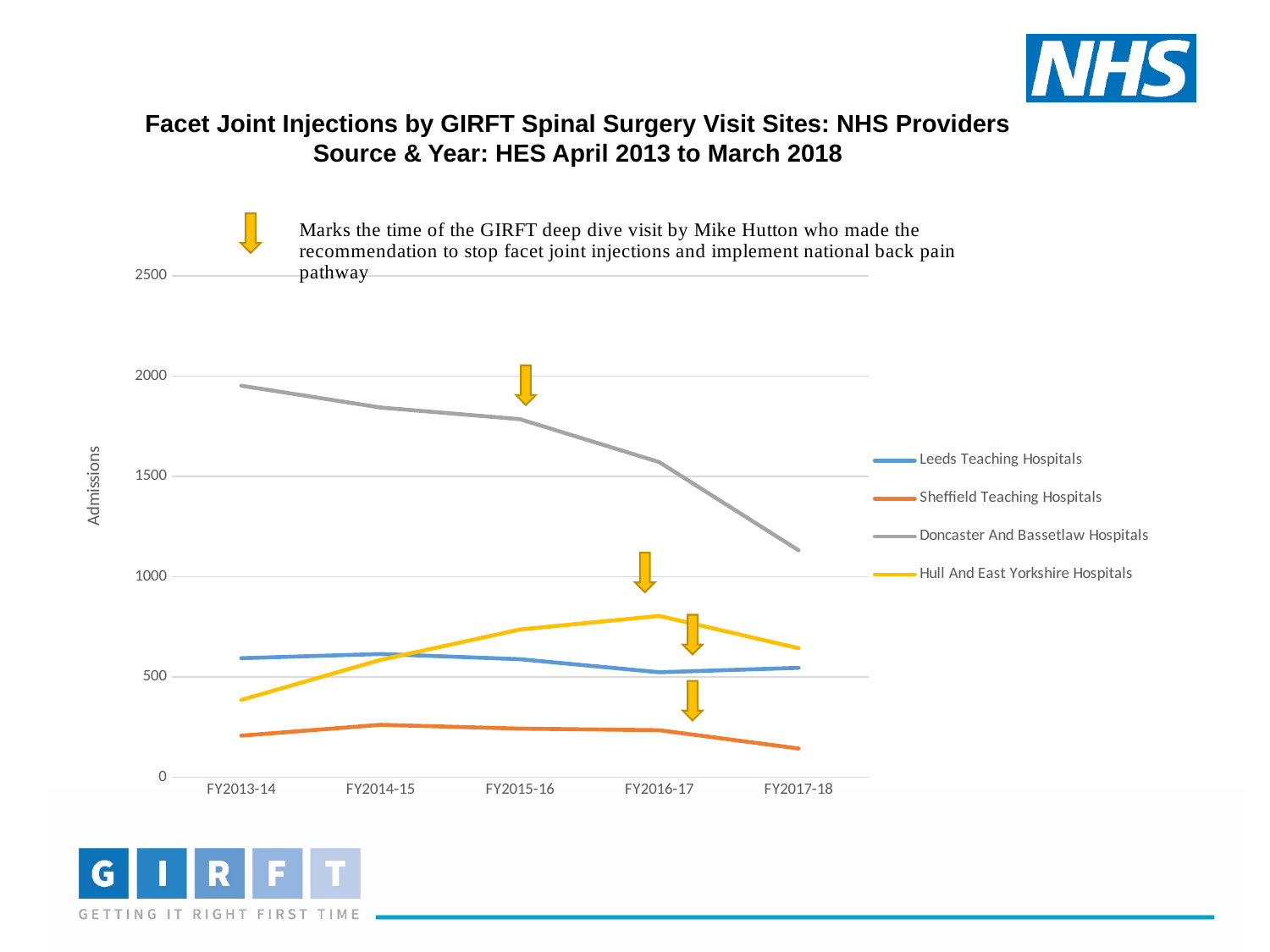
How many series does the legend list? 4 What kind of chart is shown on the slide? line chart Do the admissions for Doncaster And Bassetlaw Hospitals rise or fall from FY2013-14 to FY2017-18? fall Is the value for Doncaster And Bassetlaw Hospitals in FY2013-14 greater or less than 1500? greater Which provider has the lowest admissions in FY2017-18? Sheffield Teaching Hospitals Is the value for Hull And East Yorkshire Hospitals in FY2013-14 greater or less than 500? less In FY2017-18, which is larger: the value for Hull And East Yorkshire Hospitals or the value for Leeds Teaching Hospitals? Hull And East Yorkshire Hospitals What is the label on the vertical axis of the chart? Admissions Is the value for Sheffield Teaching Hospitals in FY2014-15 greater or less than 500? less Which provider has the highest admissions in FY2013-14? Doncaster And Bassetlaw Hospitals How many financial years are plotted along the x axis? 5